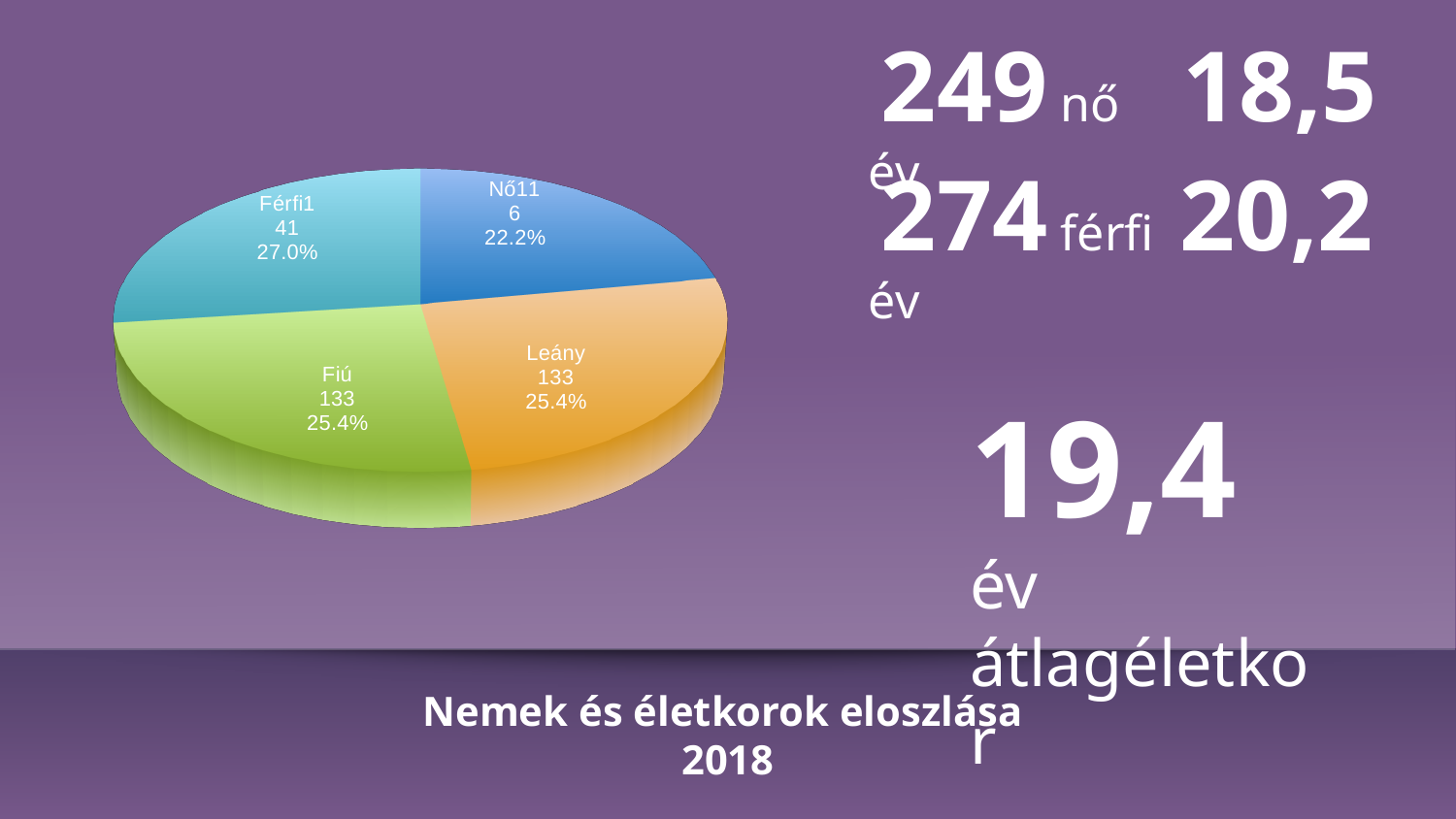
What is the difference in percentage share between the Leány slice and the Nő slice? 3.2% Which slice has the smallest share of the pie? Nő What percentage share does the Nő slice have? 22.2% What is the difference in percentage share between the Férfi slice and the Nő slice? 4.8% What is the value shown for the Leány slice? 133 Which slice has a larger share, Férfi or Nő? Férfi Which slice has the largest share of the pie? Férfi What percentage share does the Fiú slice have? 25.4% How many slices does the pie chart have? 4 What kind of chart is shown on the slide? pie chart What is the title of the chart? Nemek és életkorok eloszlása 2018 What percentage share does the Férfi slice have? 27.0%